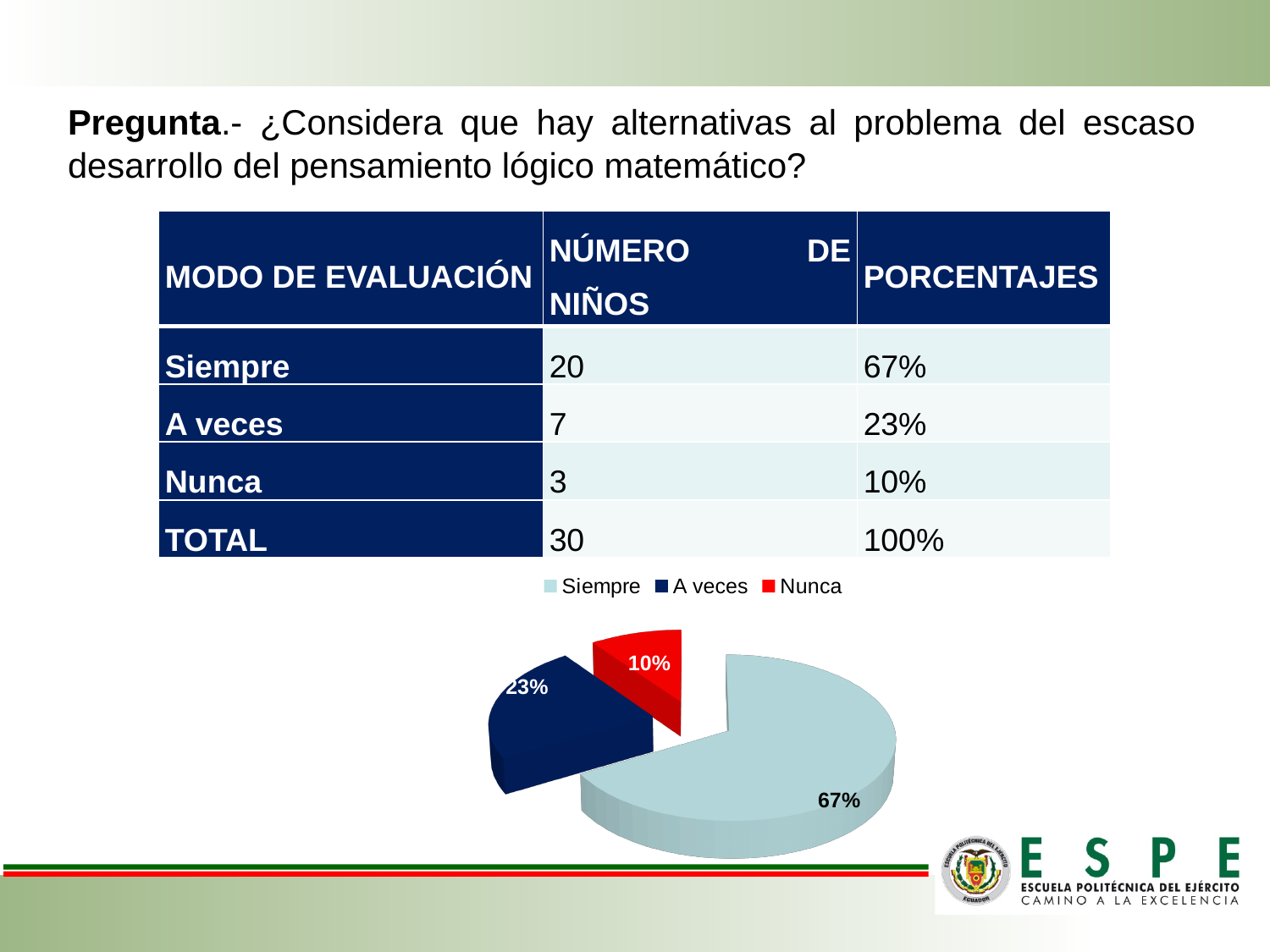
What percentage does the A veces slice show in the pie chart? 23% What colour is the Nunca slice in the pie chart? Red What percentage does the Nunca slice show in the pie chart? 10% What is the difference in percentage points between the A veces and Nunca slices? 13 What is the difference in percentage points between the Siempre and A veces slices? 44 What percentage does the Siempre slice show in the pie chart? 67% How many slices does the pie chart have? 3 How many entries does the legend of the pie chart list? 3 Which category has the largest slice in the pie chart? Siempre Which slice is larger in the pie chart, A veces or Nunca? A veces What kind of chart is shown on the slide? Pie chart Which category has the smallest slice in the pie chart? Nunca